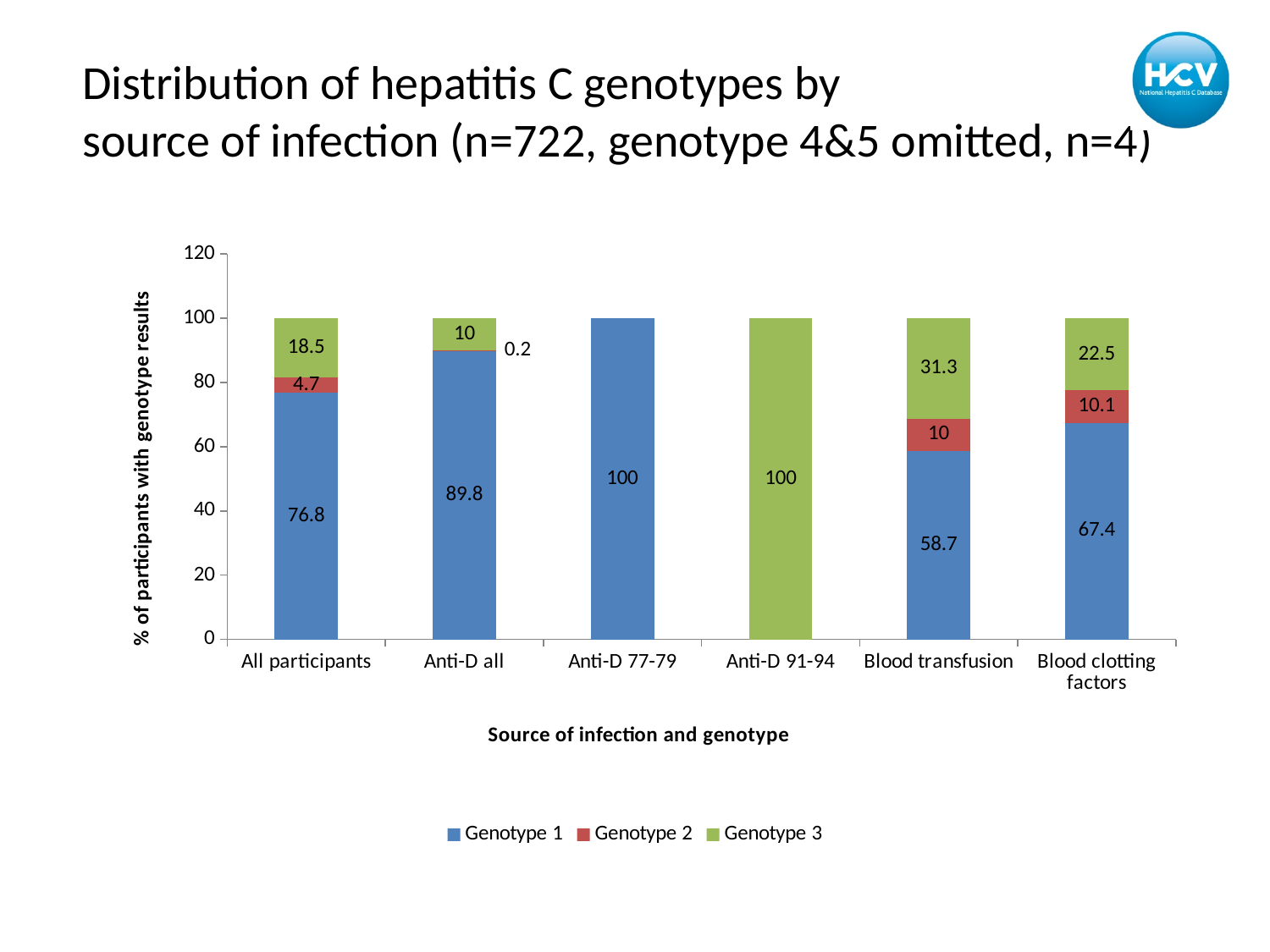
What is the Genotype 1 value for Blood clotting factors? 67.4 What kind of chart is shown? Stacked bar chart What is the label of the y axis? % of participants with genotype results What is the difference between the Genotype 1 values for Anti-D all and Blood transfusion? 31.1 What is the Genotype 3 value for Blood transfusion? 31.3 What is the Genotype 2 value for Anti-D all? 0.2 Which source of infection has the highest Genotype 3 value? Anti-D 91-94 Is the Genotype 2 value larger for Blood transfusion or for Blood clotting factors? Blood clotting factors What is the Genotype 1 value for All participants? 76.8 Which source of infection has the lowest Genotype 1 value among those with a Genotype 1 bar? Blood transfusion How many source-of-infection categories are shown on the x axis? 6 How many series does the legend list? 3